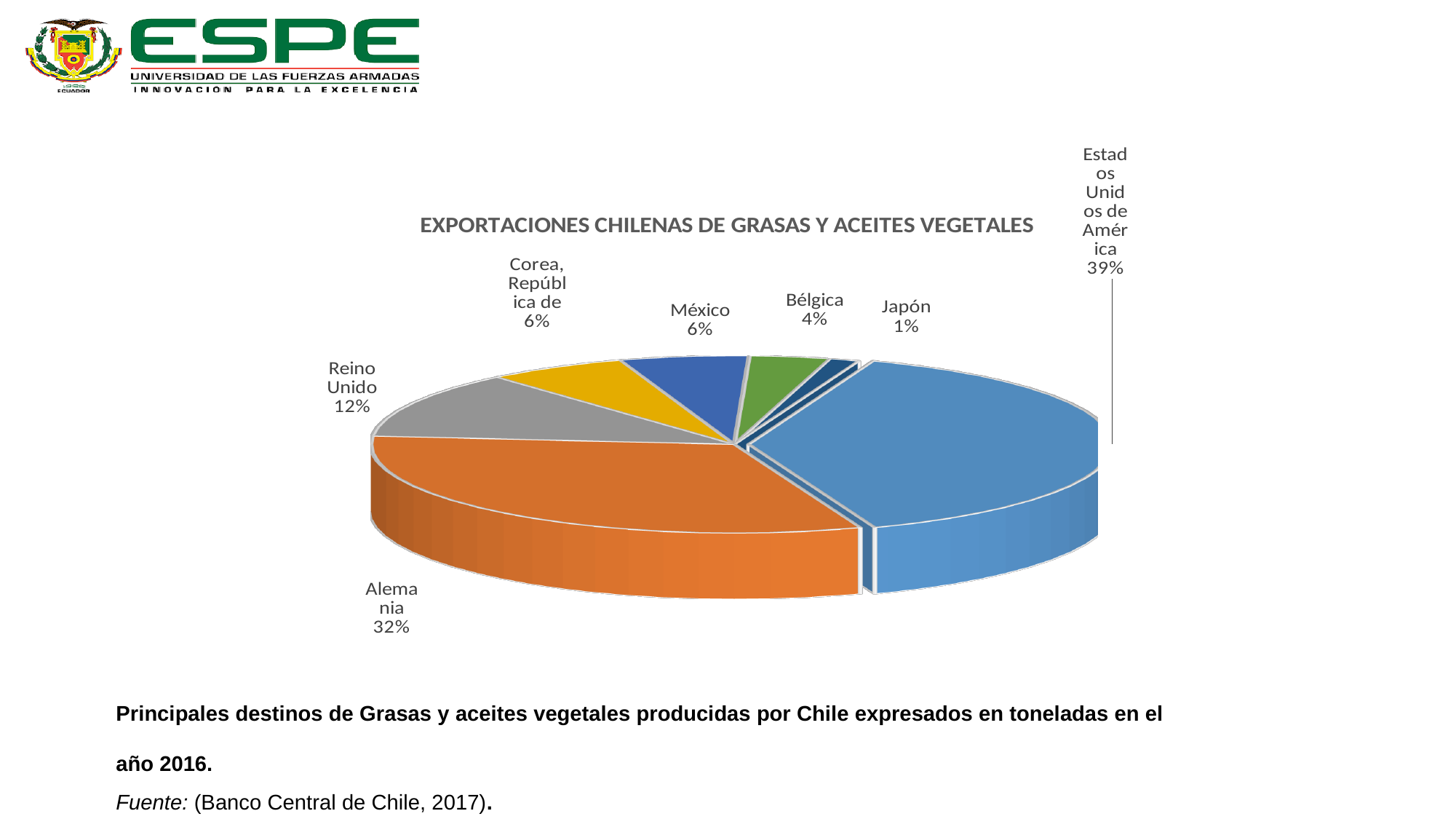
Which destination has the largest share of the pie? Estados Unidos de América What kind of chart is shown on the slide? Pie chart What share of the pie does Alemania hold? 32% What is the difference in percentage points between Estados Unidos de América and Alemania? 7 What is the value shown for Bélgica? 4% What is the value shown for Japón? 1% Which destination has the smallest share of the pie? Japón What is the title of the chart? EXPORTACIONES CHILENAS DE GRASAS Y ACEITES VEGETALES What share of the pie does Estados Unidos de América hold? 39% Which has a larger share, Reino Unido or México? Reino Unido What is the value shown for Reino Unido? 12% How many destinations (slices) are shown in the pie chart? 7